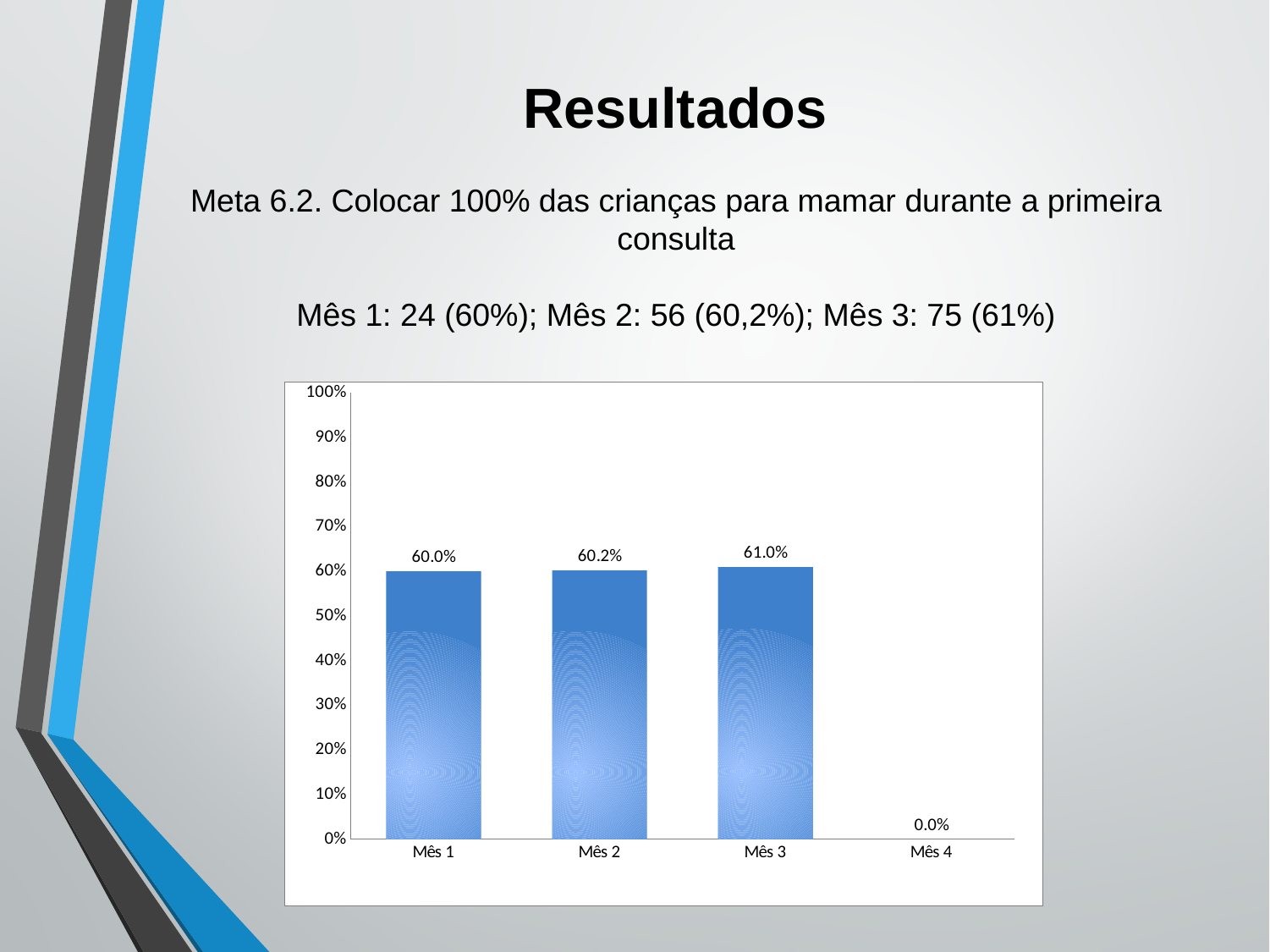
How many categories are shown on the x axis? 4 What is the value for Mês 4? 0.0% Which category has the highest value? Mês 3 What is the value for Mês 2? 60.2% What is the value for Mês 3? 61.0% What is the difference between the values for Mês 3 and Mês 1? 1.0% What is the value for Mês 1? 60.0% Which category has the lowest value? Mês 4 Which is larger, the value for Mês 3 or the value for Mês 4? Mês 3 Is the value for Mês 2 greater or less than 70%? less What kind of chart is shown on the slide? bar chart What is the difference between the values for Mês 3 and Mês 2? 0.8%